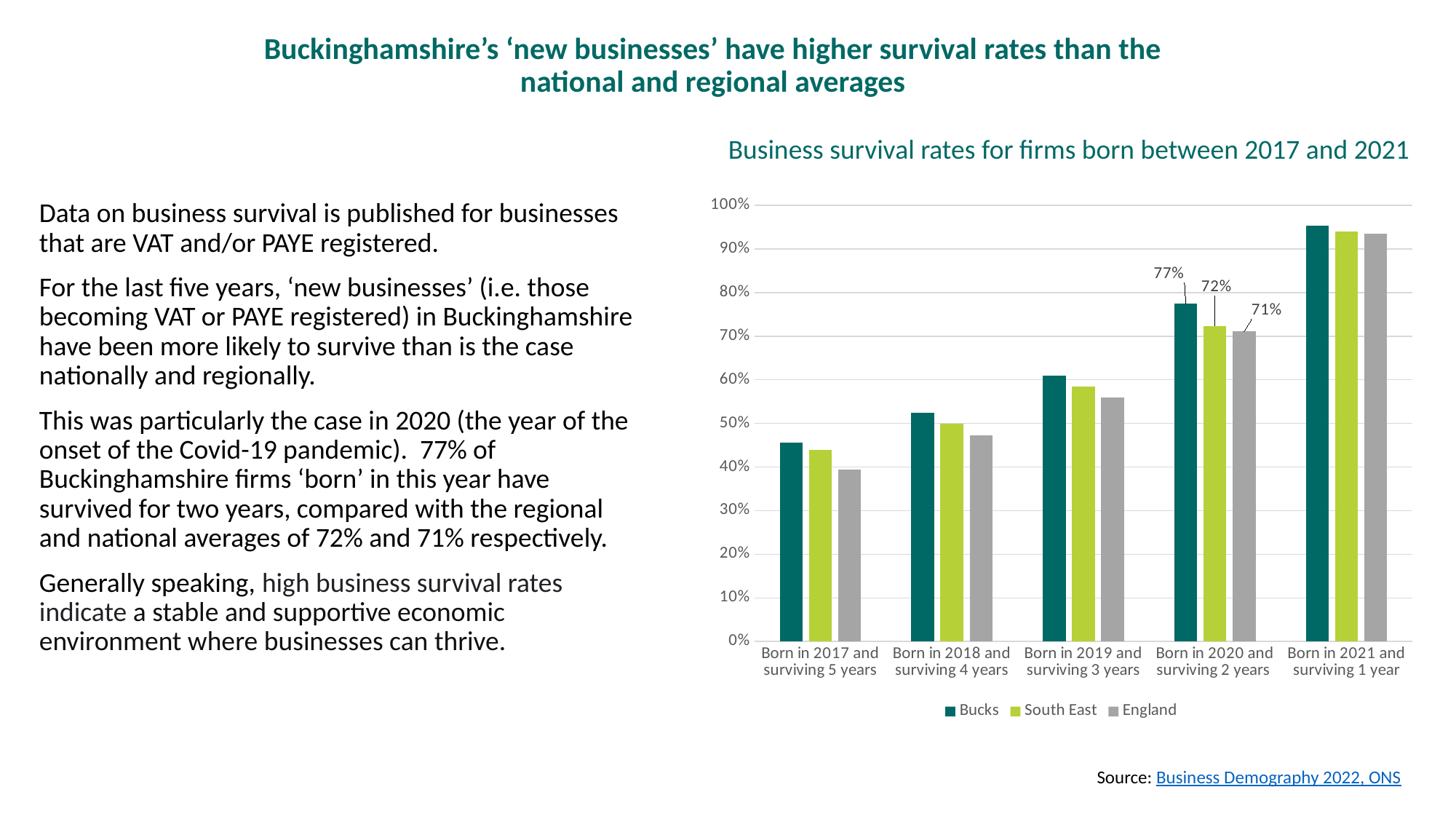
What is the difference between the Bucks and England survival rates for firms born in 2020 and surviving 2 years? 6 percentage points Which category has the lowest survival rates across all three series? Born in 2017 and surviving 5 years What is the Bucks survival rate for firms born in 2020 and surviving 2 years? 77% Which category has the highest survival rates across all three series? Born in 2021 and surviving 1 year Is the Bucks value for firms born in 2021 and surviving 1 year greater or less than 90%? greater How many categories are shown on the x axis? 5 Do the survival rates rise or fall moving from left to right along the x axis? rise What is the England survival rate for firms born in 2020 and surviving 2 years? 71% For firms born in 2019 and surviving 3 years, which is larger: the Bucks value or the England value? Bucks How many series does the legend list? 3 What is the South East survival rate for firms born in 2020 and surviving 2 years? 72%